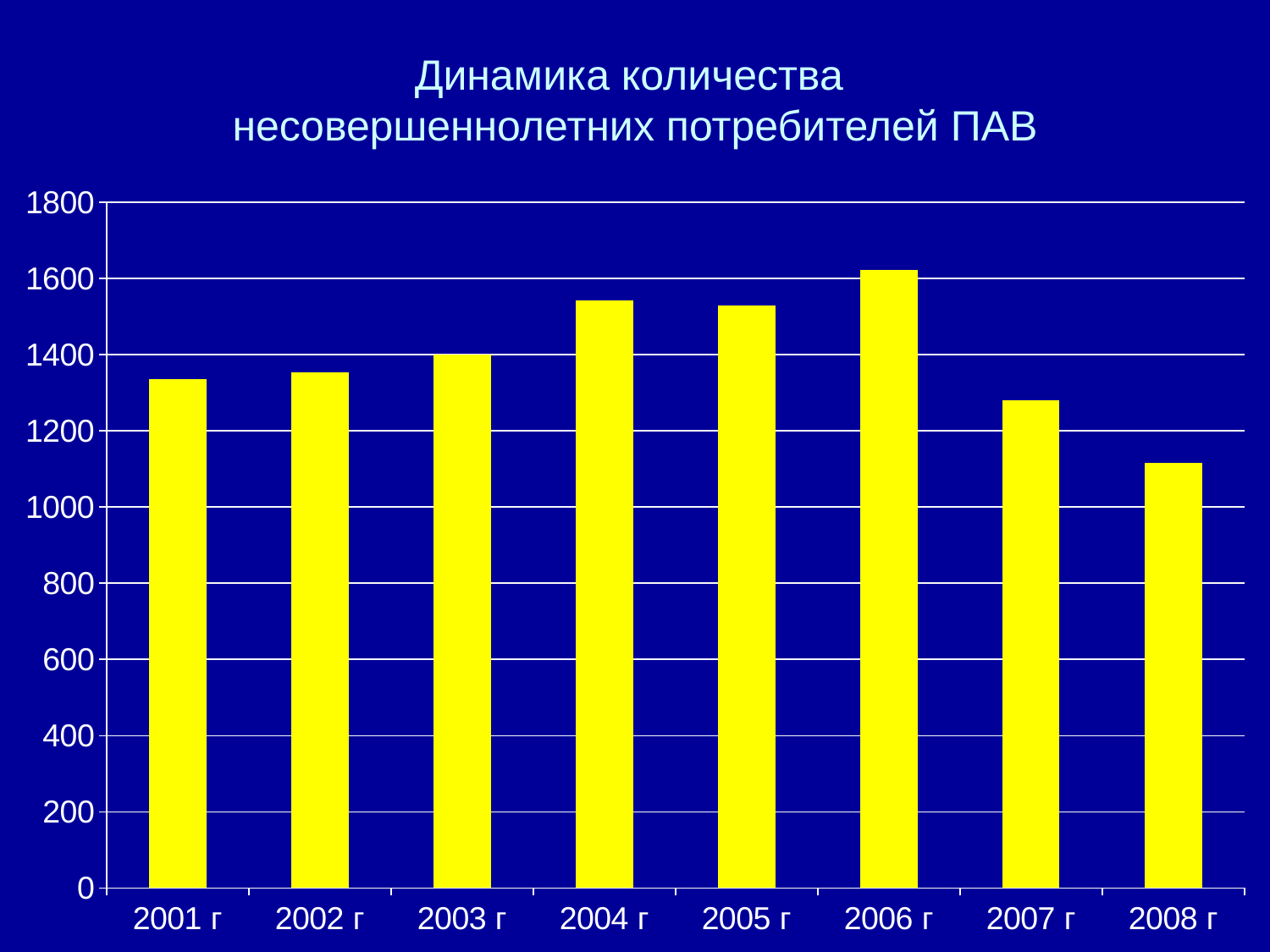
Which is larger, the value for 2006 г or the value for 2007 г? 2006 г What is the title of the chart on the slide? Динамика количества несовершеннолетних потребителей ПАВ Is the value for 2008 г greater or less than 1200? less Is the value for 2006 г greater or less than 1600? greater Is the value for 2001 г greater or less than 1200? greater What kind of chart is shown on the slide? bar chart How many years are shown on the x axis of the chart? 8 Which year has the lowest value in the chart? 2008 г Do the values rise or fall from 2006 г to 2008 г? fall Which year has the highest value in the chart? 2006 г